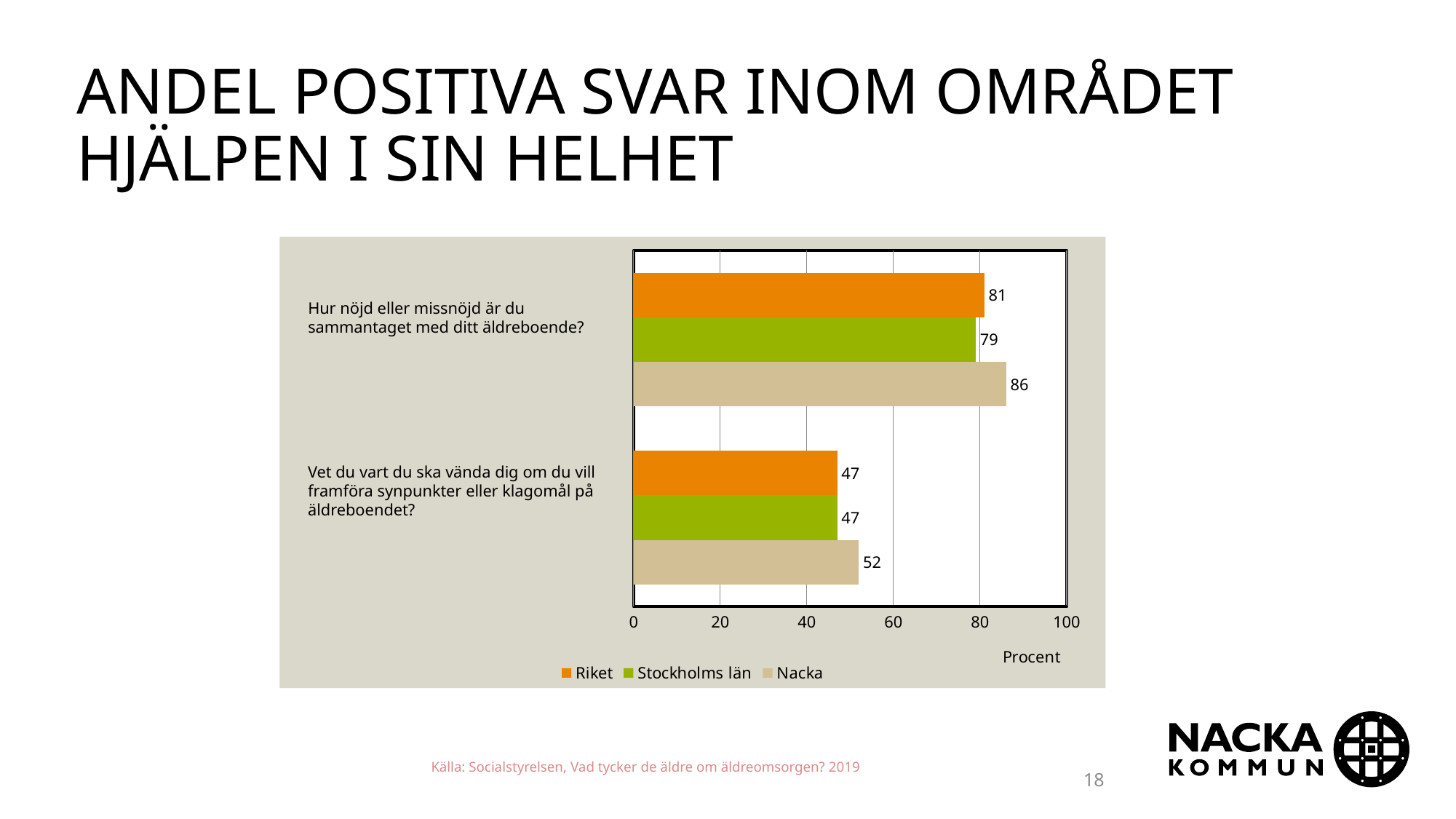
What is the value for Nacka on the question "Hur nöjd eller missnöjd är du sammantaget med ditt äldreboende?"? 86 Which series has the highest value on the question "Hur nöjd eller missnöjd är du sammantaget med ditt äldreboende?"? Nacka Which is larger: the Riket value or the Nacka value on the question "Vet du vart du ska vända dig om du vill framföra synpunkter eller klagomål på äldreboendet?"? Nacka What is the value for Riket on the question "Hur nöjd eller missnöjd är du sammantaget med ditt äldreboende?"? 81 What is the label on the horizontal axis of the chart? Procent Which series has the lowest value on the question "Hur nöjd eller missnöjd är du sammantaget med ditt äldreboende?"? Stockholms län How many series does the legend list? 3 What is the difference between the Nacka and Riket values on the question "Vet du vart du ska vända dig om du vill framföra synpunkter eller klagomål på äldreboendet?"? 5 What is the value for Stockholms län on the question "Vet du vart du ska vända dig om du vill framföra synpunkter eller klagomål på äldreboendet?"? 47 What is the difference between the Nacka and Stockholms län values on the question "Hur nöjd eller missnöjd är du sammantaget med ditt äldreboende?"? 7 What kind of chart is shown on the slide? Bar chart What is the value for Nacka on the question "Vet du vart du ska vända dig om du vill framföra synpunkter eller klagomål på äldreboendet?"? 52